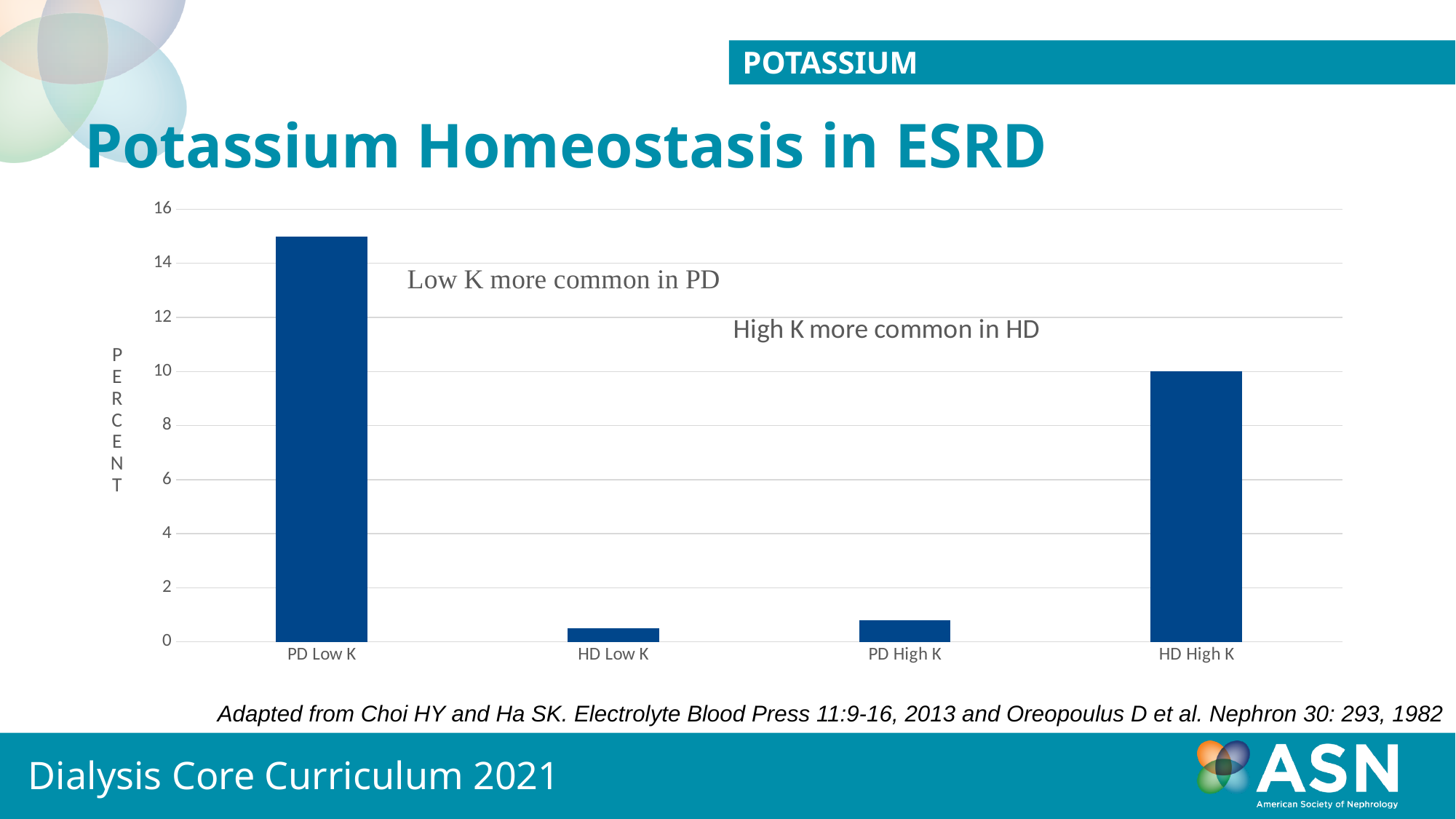
Is the value for PD High K greater or less than 2? less What is the title of the slide containing the chart? Potassium Homeostasis in ESRD Is the value for HD Low K greater or less than 2? less Which is larger, the value for PD Low K or the value for HD High K? PD Low K Which is larger, the value for HD Low K or the value for HD High K? HD High K How many categories are plotted on the x axis? 4 What is the label on the vertical axis? PERCENT Which category has the highest value? PD Low K Is the value for HD High K greater or less than 12? less What is the value for HD High K? 10 What kind of chart is shown on the slide? bar chart